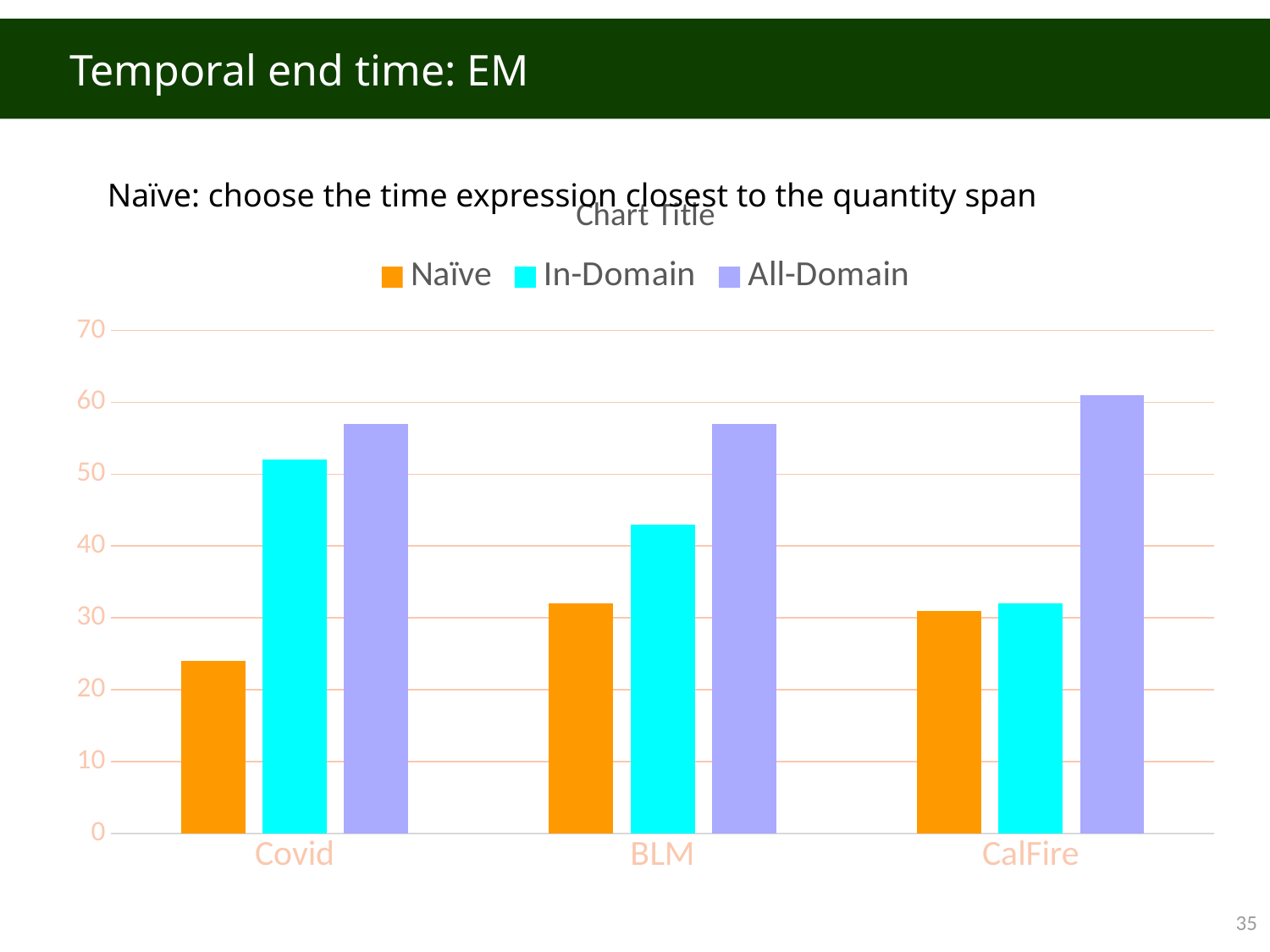
What colour are the Naïve bars? orange Which category has the lowest Naïve value? Covid Is the In-Domain value for Covid greater or less than 50? greater How many series does the legend list? 3 Is the Naïve value for Covid greater or less than 30? less How many categories are shown on the x axis? 3 Which series has the highest value for Covid? All-Domain Which is larger for BLM, the In-Domain value or the Naïve value? In-Domain Which series has the lowest value for BLM? Naïve What kind of chart is shown on the slide? bar chart Which category has the highest All-Domain value? CalFire